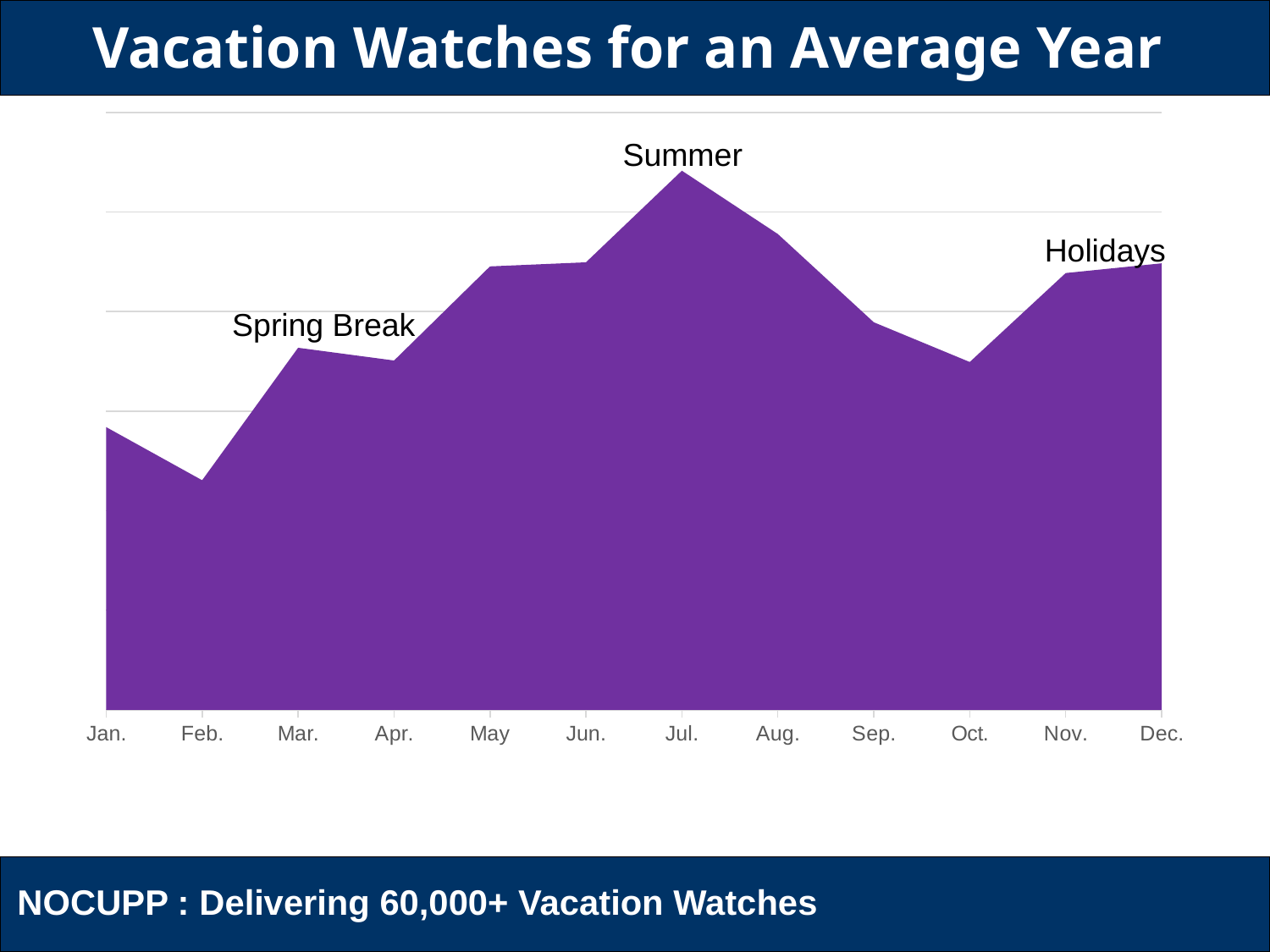
Which is larger, the value for Jul. or the value for Feb.? Jul. Which is larger, the value for Dec. or the value for Oct.? Dec. How many months are shown along the x axis of the chart? 12 Do the values rise or fall from Jul. to Oct.? Fall Which is larger, the value for Mar. or the value for Jan.? Mar. Which month has the lowest value in the chart? Feb. Which label is placed above the peak at Jul. in the chart? Summer Do the values rise or fall from Oct. to Dec.? Rise What kind of chart is shown on the slide? Area chart Which month has the highest value in the chart? Jul. Do the values rise or fall from Jan. to Feb.? Fall What is the title of the chart? Vacation Watches for an Average Year